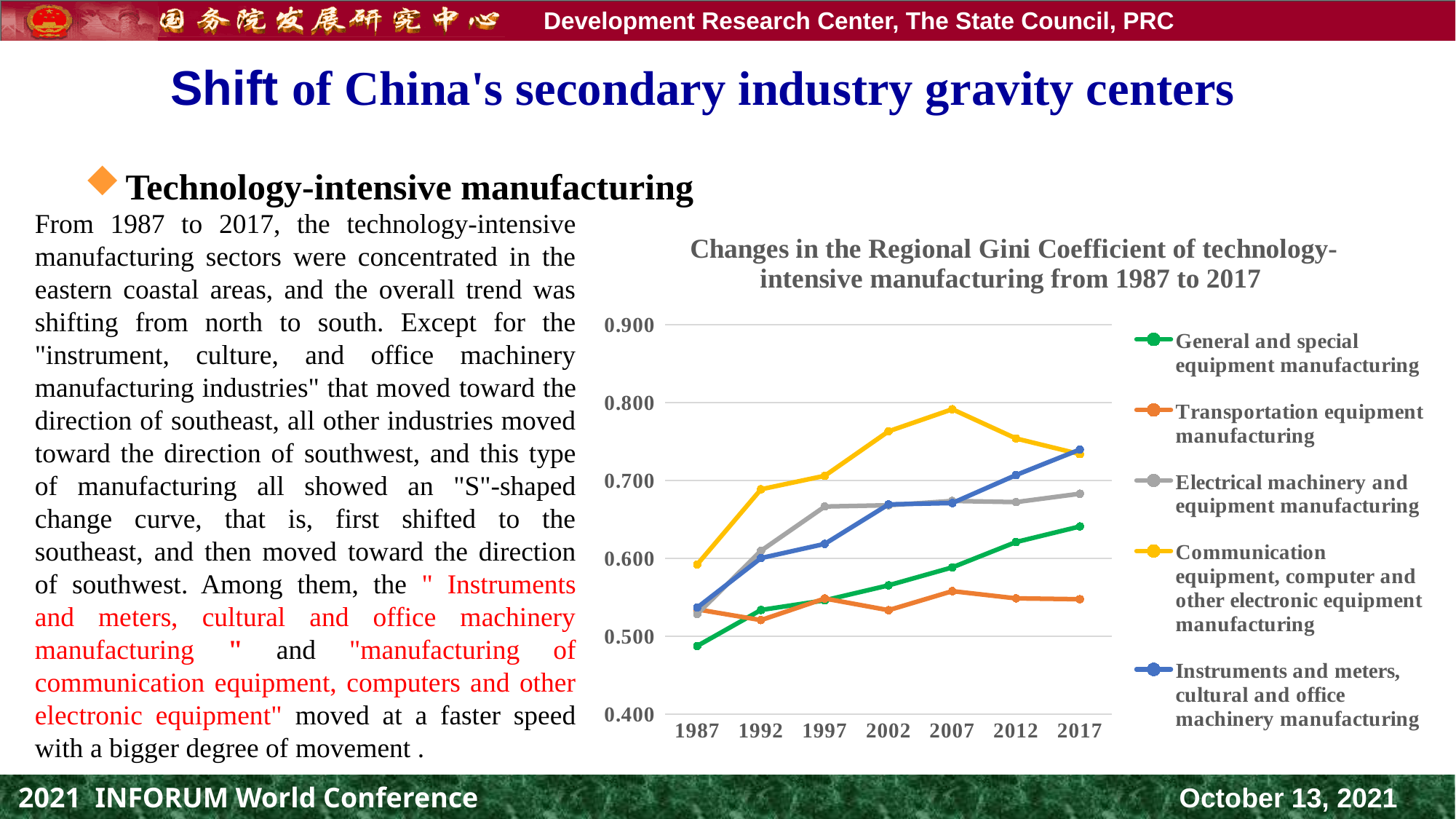
In 2012, which is larger: the value for Communication equipment, computer and other electronic equipment manufacturing or the value for General and special equipment manufacturing? Communication equipment, computer and other electronic equipment manufacturing Which series has the highest value in 2007? Communication equipment, computer and other electronic equipment manufacturing Which series has the lowest value in 2017? Transportation equipment manufacturing How many years are plotted along the x axis? 7 How many series does the legend list? 5 What kind of chart is shown on the slide? line chart Is the value for Communication equipment, computer and other electronic equipment manufacturing in 2007 greater or less than 0.700? greater What is the title of the chart? Changes in the Regional Gini Coefficient of technology-intensive manufacturing from 1987 to 2017 Does the value for General and special equipment manufacturing rise or fall from 1987 to 2017? rise Which series has the lowest value in 1987? General and special equipment manufacturing Is the value for General and special equipment manufacturing in 1987 greater or less than 0.500? less Is the value for Transportation equipment manufacturing in 2017 greater or less than 0.600? less